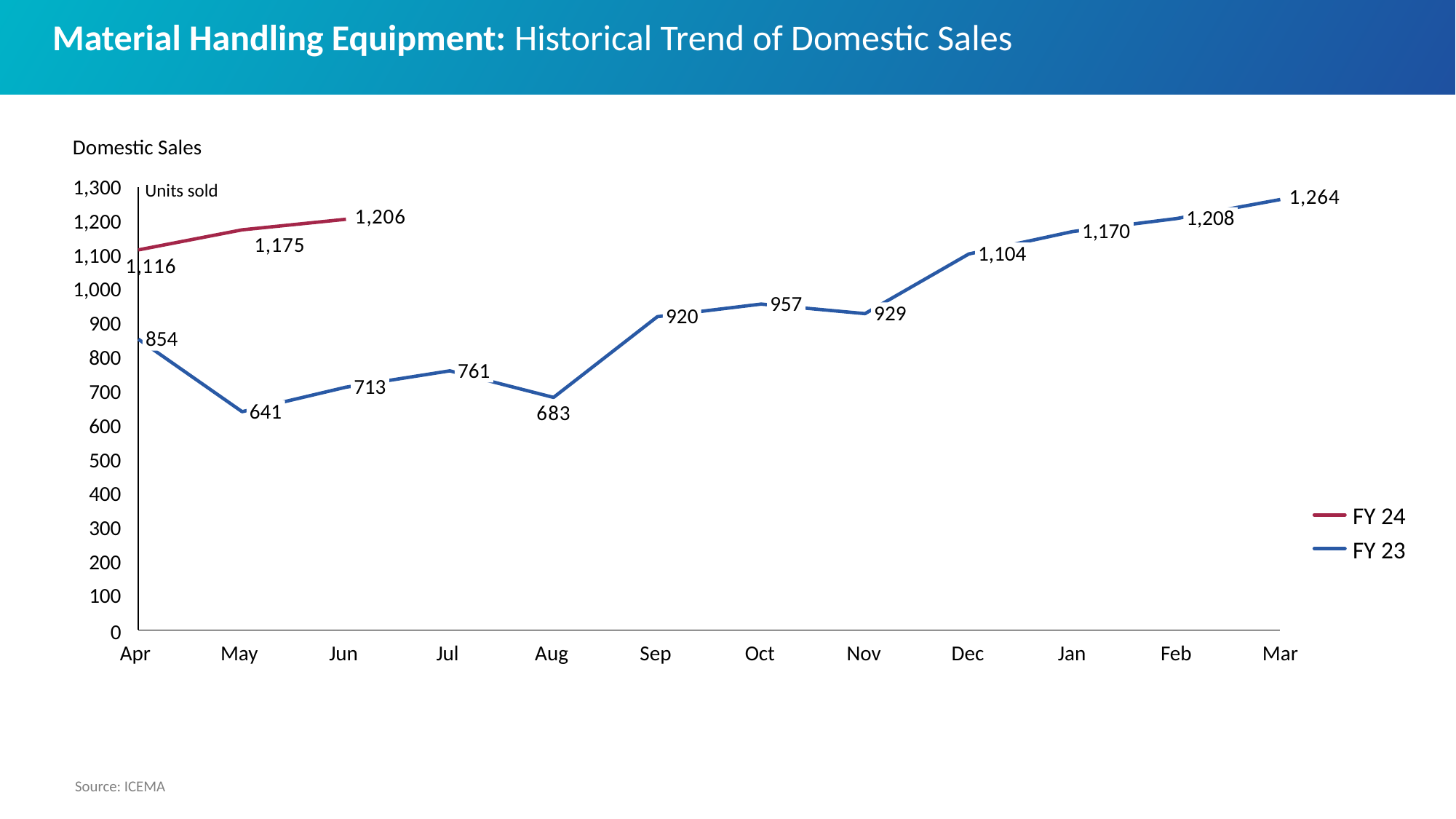
What is the difference between the FY 24 and FY 23 values for Apr? 262 Do the FY 24 values rise or fall from Apr to Jun? Rise What is the FY 23 domestic sales value for Apr? 854 Which month has the lowest FY 23 value? May Which is larger, the FY 23 value for Jul or for Aug? Jul What kind of chart is shown on the slide? Line chart Which month has the highest FY 23 value? Mar What is the FY 23 value for Nov? 929 What is the FY 24 domestic sales value for Jun? 1,206 How many series does the legend list? 2 What is the difference between the FY 23 values for Mar and Feb? 56 How many months are shown on the x axis? 12